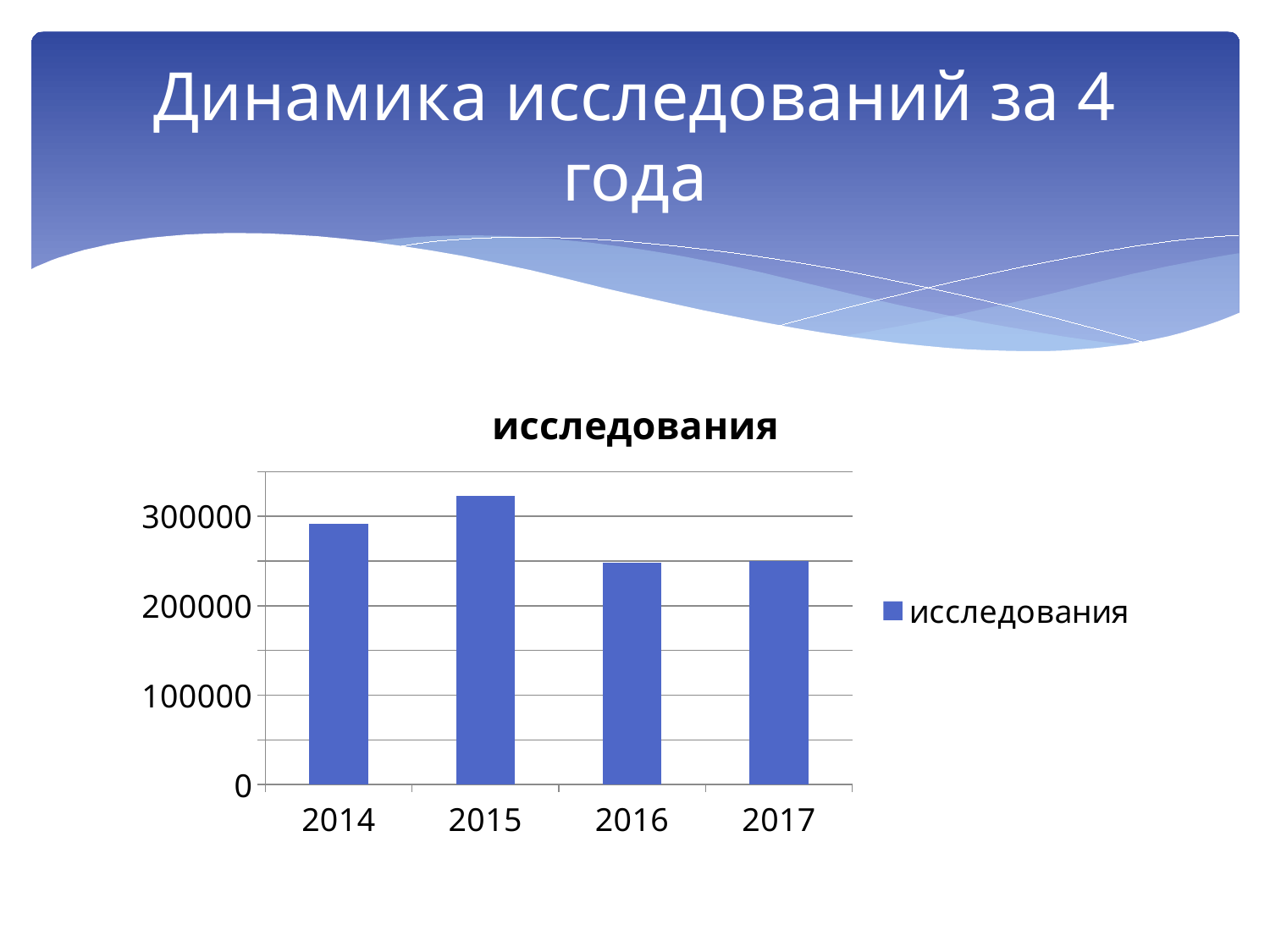
Is the value for 2014 greater or less than 200000? greater What is the title of the chart? исследования Which is larger, the value for 2014 or the value for 2016? 2014 What kind of chart is shown on the slide? bar chart Is the value for 2015 greater or less than 300000? greater Is the value for 2016 greater or less than 300000? less How many years are shown on the x axis of the chart? 4 Which year has the highest value in the chart? 2015 Which is larger, the value for 2015 or the value for 2017? 2015 Does the value rise or fall from 2015 to 2016? fall How many series does the legend list? 1